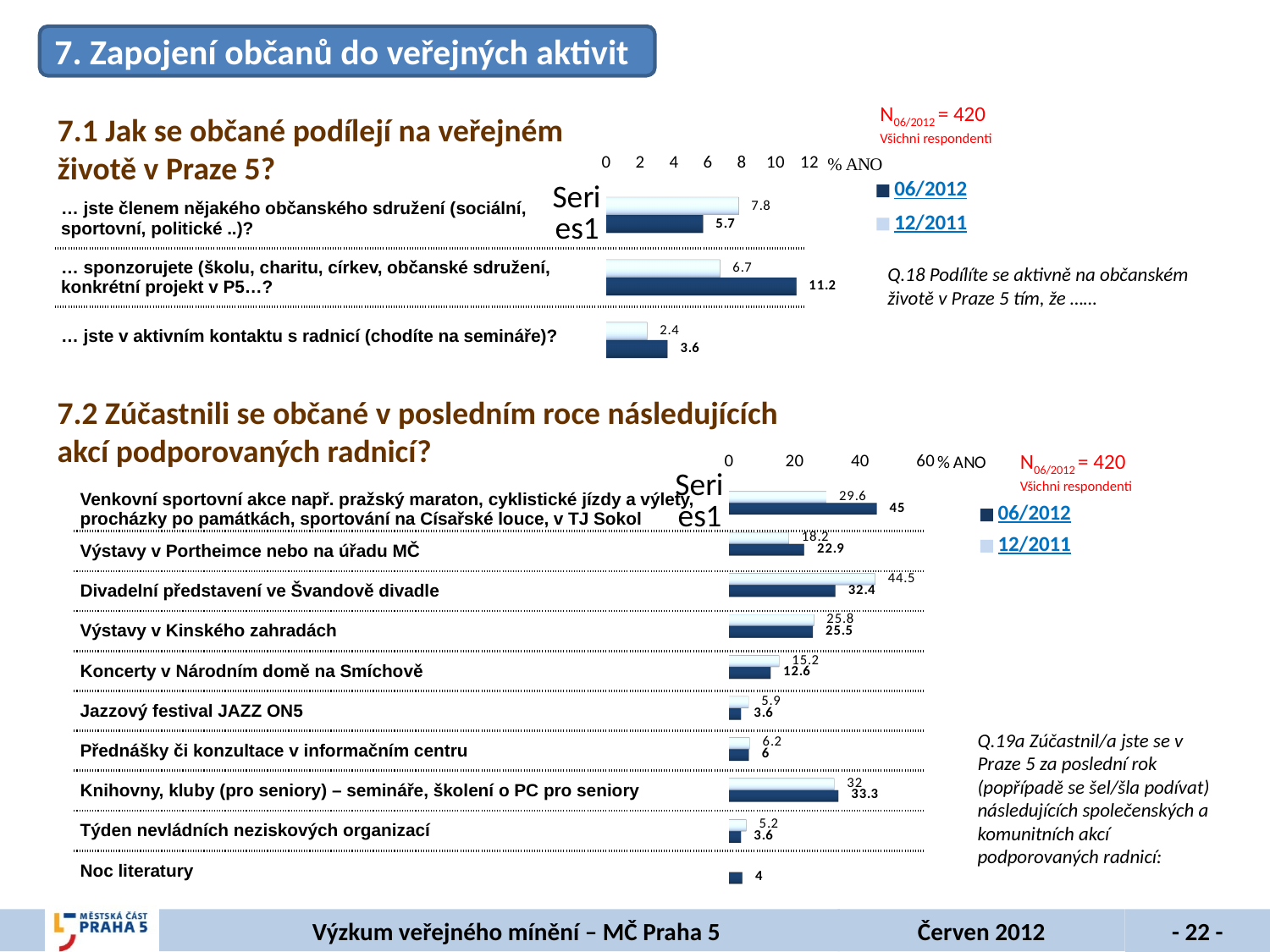
What type of chart is used for 7.2? Bar chart In the chart for 7.1, what is the difference between the 06/2012 and 12/2011 values for '… sponzorujete'? 4.5 In the chart for 7.2, which category has the highest 06/2012 value? Venkovní sportovní akce In the chart for 7.1, which category has the lowest 12/2011 value? … jste v aktivním kontaktu s radnicí (chodíte na semináře)? In the chart for 7.2, what is the 12/2011 value for 'Divadelní představení ve Švandově divadle'? 44.5 In the chart for 7.1, what is the 06/2012 value for '… jste členem nějakého občanského sdružení'? 5.7 In the chart for 7.2, what is the difference between the 12/2011 and 06/2012 values for 'Výstavy v Portheimce nebo na úřadu MČ'? 4.7 In the chart for 7.2, what is the 06/2012 value for 'Venkovní sportovní akce'? 45 In the chart for 7.2, how many categories are plotted? 10 In the chart for 7.2, which is larger for 'Koncerty v Národním domě na Smíchově': the 06/2012 value or the 12/2011 value? 12/2011 In the chart for 7.1, how many series does the legend list? 2 In the chart for 7.1, what is the 12/2011 value for '… sponzorujete (školu, charitu, církev, občanské sdružení, konkrétní projekt v P5…)?' 6.7